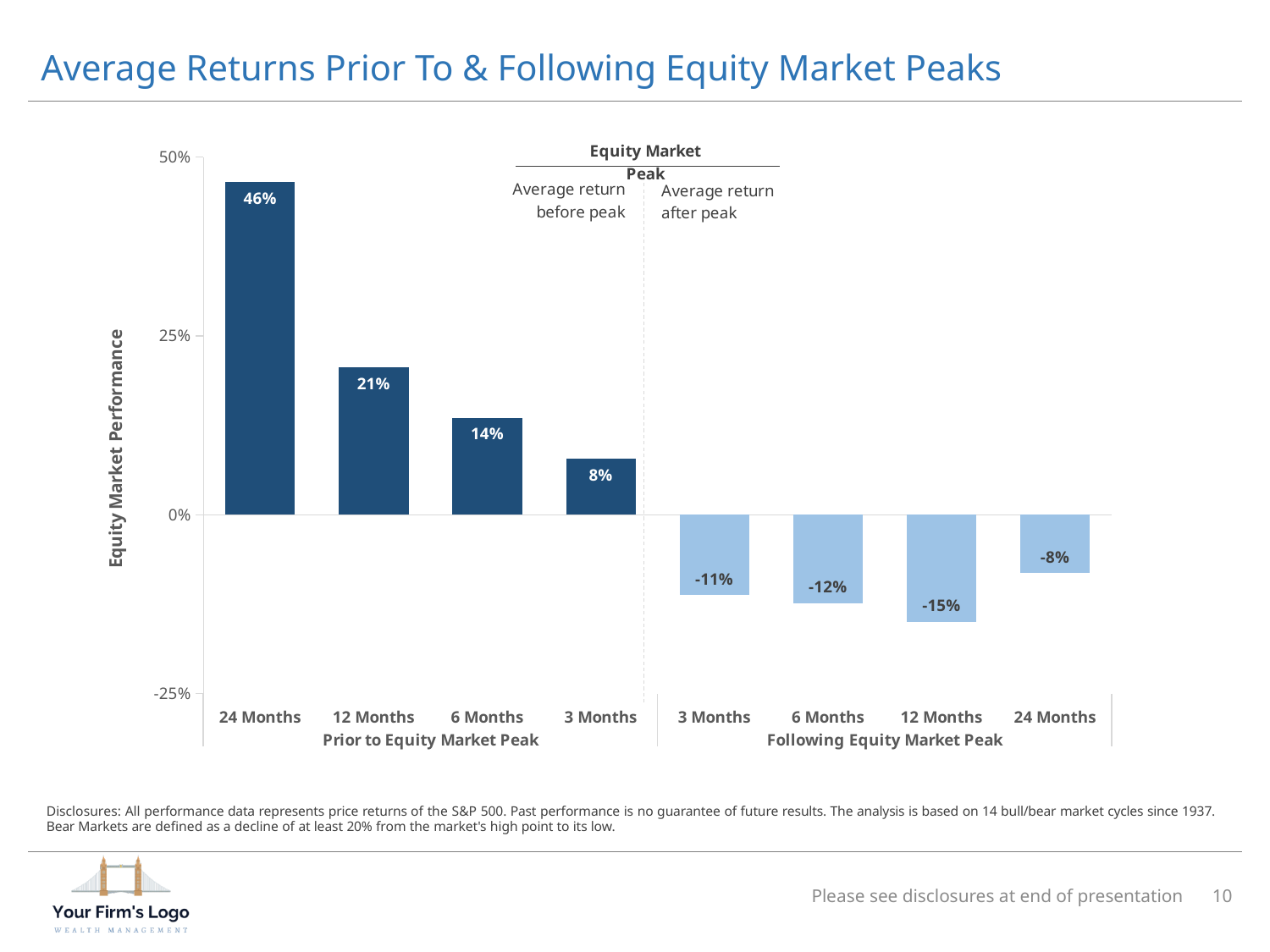
Which category has the highest average return? 24 Months Prior to Equity Market Peak What is the average return 24 months prior to the equity market peak? 46% Which category has the lowest average return? 12 Months Following Equity Market Peak Do the average returns rise or fall across the four categories prior to the equity market peak, from 24 months to 3 months? Fall What is the difference between the average return 24 months prior to the peak and 12 months prior to the peak? 25% What type of chart is shown on the slide? Bar chart What is the average return 3 months prior to the equity market peak? 8% What is the average return 6 months following the equity market peak? -12% Which is larger in magnitude: the average return 3 months following the peak or 24 months following the peak? 3 Months Following Equity Market Peak What is the label of the vertical axis? Equity Market Performance How many bars are plotted on the chart? 8 What is the average return 12 months following the equity market peak? -15%